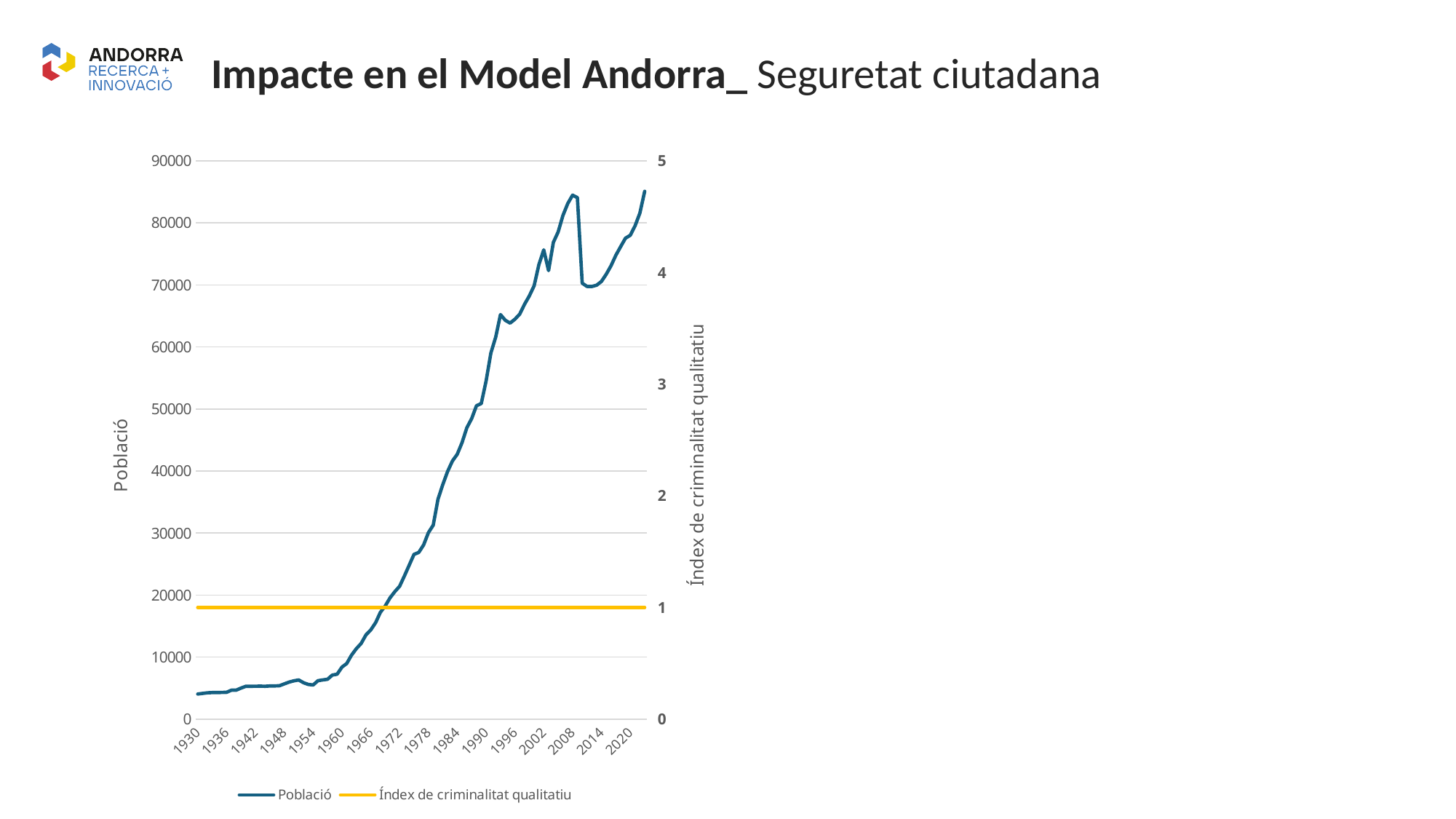
Is the Població value for 1930 greater or less than 10000? less Is the Població value for 1996 greater or less than 60000? greater Which is larger, the Població value for 2008 or for 2014? 2008 What kind of chart is shown on the slide? line chart Which year has the lowest Població value? 1930 Is the Població value for 2020 greater or less than 80000? less What is the value of the Índex de criminalitat qualitatiu series on the right axis? 1 How many series does the legend list? 2 Does the Població series generally rise or fall from 1930 to 2020? rise What is the title of the right-hand vertical axis? Índex de criminalitat qualitatiu